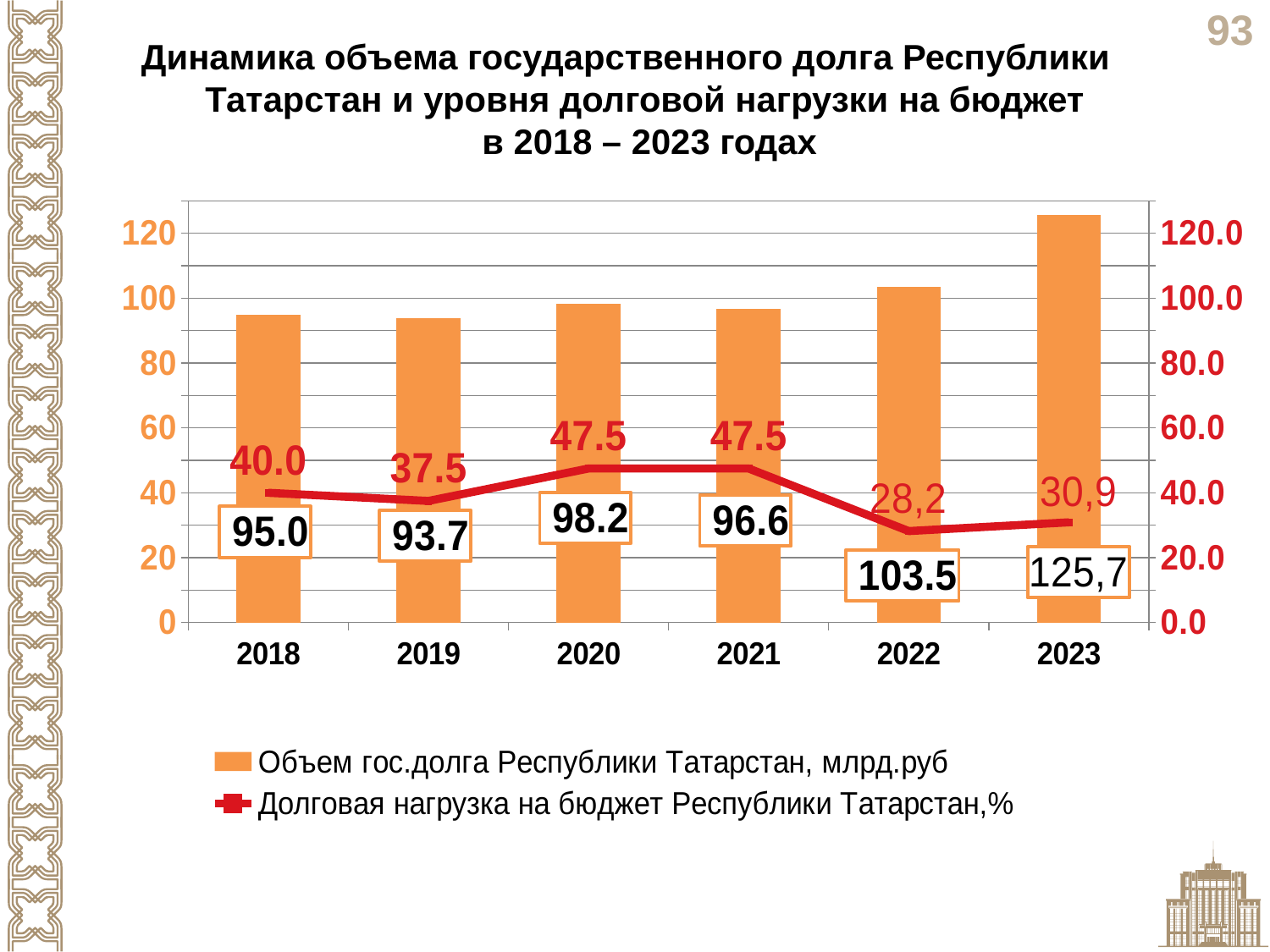
Which is larger: the bar value for 2018 or for 2021 (Объем гос.долга, млрд.руб)? 2021 Which year has the lowest value for Объем гос.долга Республики Татарстан, млрд.руб? 2019 Does the debt burden (Долговая нагрузка на бюджет Республики Татарстан,%) rise or fall from 2021 to 2022? fall What is the value of the bar for 2023 (Объем гос.долга Республики Татарстан, млрд.руб)? 125,7 What is the debt burden (Долговая нагрузка на бюджет Республики Татарстан,%) value for 2019? 37.5 What is the value of the bar for 2020 (Объем гос.долга Республики Татарстан, млрд.руб)? 98.2 What is the debt burden (Долговая нагрузка на бюджет Республики Татарстан,%) value for 2022? 28,2 Which year has the lowest debt burden (Долговая нагрузка на бюджет Республики Татарстан,%)? 2022 Which year has the highest value for Объем гос.долга Республики Татарстан, млрд.руб? 2023 How many years are shown on the x axis of the chart? 6 What is the difference between the bar values for 2023 and 2022 (Объем гос.долга, млрд.руб)? 22.2 How many series does the legend list? 2